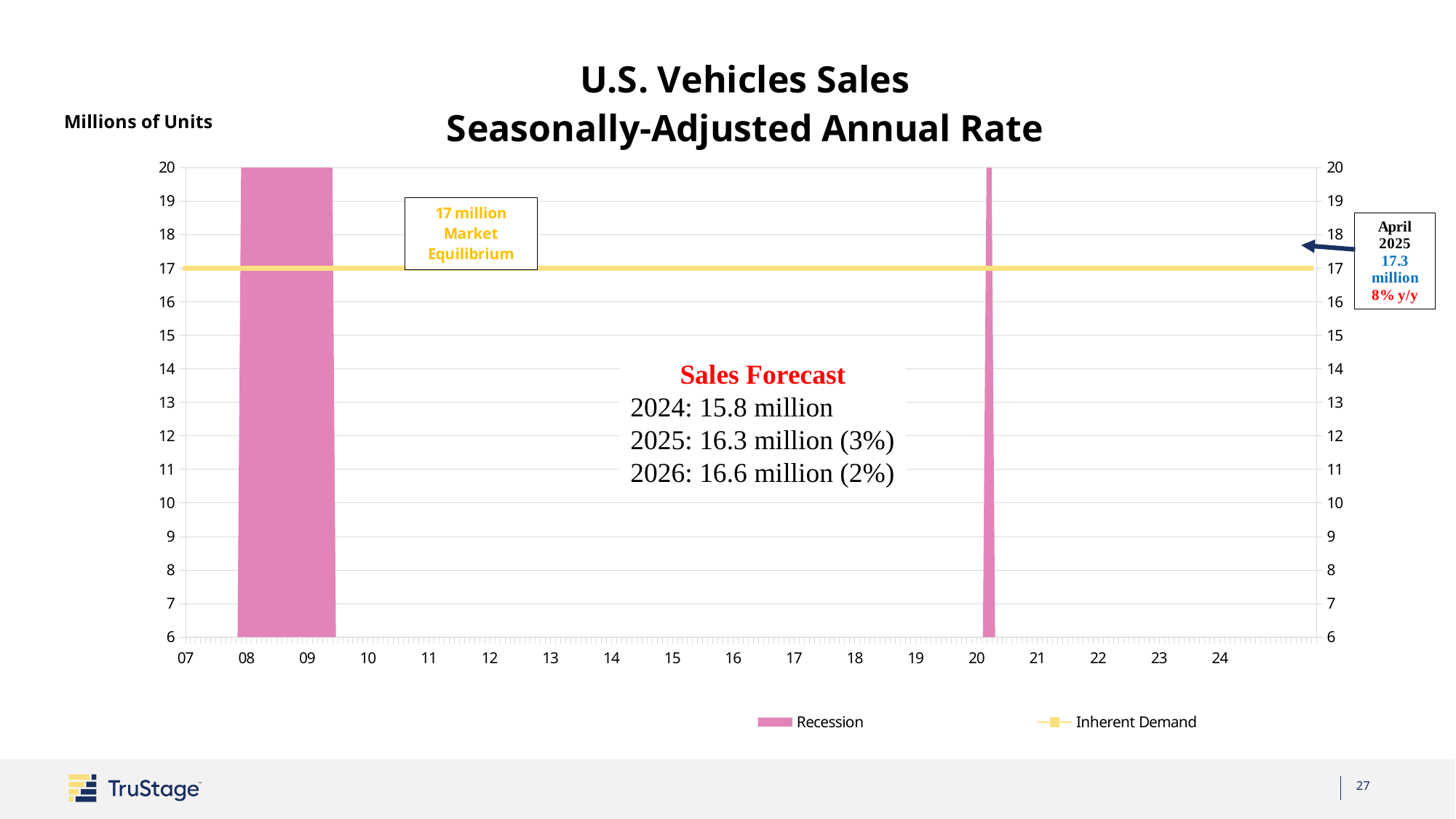
What is the title of the chart? U.S. Vehicles Sales Seasonally-Adjusted Annual Rate Is the Inherent Demand line greater or less than 16? greater How many shaded recession periods are shown on the chart? 2 At what level is the Inherent Demand line drawn, according to the label on the chart? 17 million Which sales forecast is larger, 2024 or 2025? 2025 How many series does the legend list? 2 What is the April 2025 vehicle sales value shown in the annotation box? 17.3 million Does the Inherent Demand line rise, fall, or stay flat across the years shown? Stays flat What is the sales forecast for 2025 shown on the chart? 16.3 million Is the Inherent Demand line greater or less than 18? less What are the two entries in the chart's legend? Recession and Inherent Demand What is the difference between the 2026 and 2025 sales forecasts shown on the chart? 0.3 million